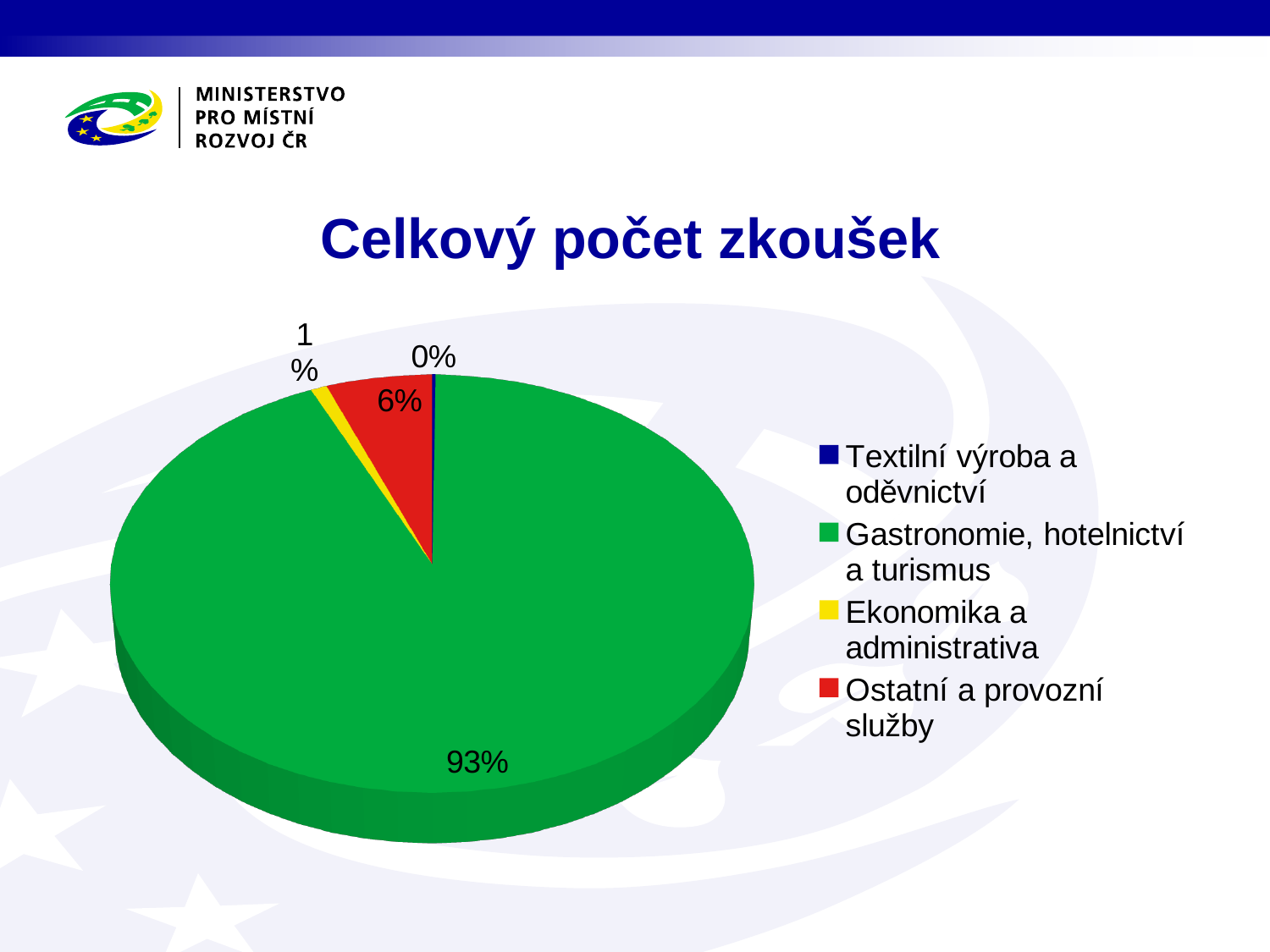
What share of the pie does Textilní výroba a oděvnictví have? 0% Which category has the smallest slice of the pie? Textilní výroba a oděvnictví Which is larger, the slice for Ostatní a provozní služby or the slice for Ekonomika a administrativa? Ostatní a provozní služby What kind of chart is shown on the slide? pie chart What share of the pie does Ostatní a provozní služby have? 6% What share of the pie does Ekonomika a administrativa have? 1% How many categories does the legend list? 4 What colour is the slice for Ekonomika a administrativa? yellow What is the title of the chart? Celkový počet zkoušek Which category has the largest slice of the pie? Gastronomie, hotelnictví a turismus What is the difference in percentage points between Gastronomie, hotelnictví a turismus and Ostatní a provozní služby? 87